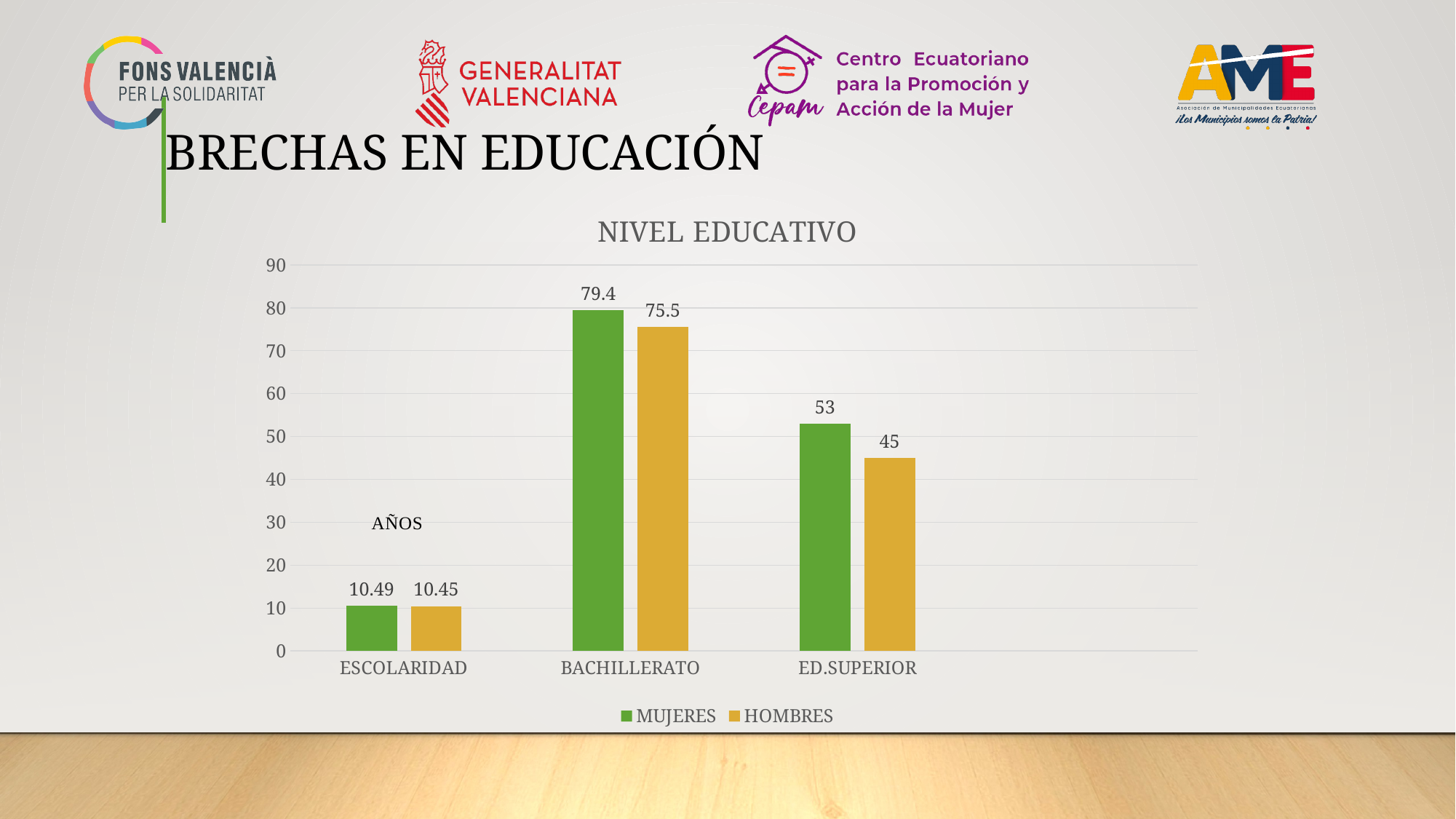
How many series does the legend list? 2 What is the difference between the MUJERES and HOMBRES values in the BACHILLERATO category? 3.9 What type of chart is shown on the slide? Bar chart In the ED.SUPERIOR category, which is larger: MUJERES or HOMBRES? MUJERES What is the value for HOMBRES in the ED.SUPERIOR category? 45 Which category has the lowest value for HOMBRES? ESCOLARIDAD How many categories are shown on the x axis? 3 What is the value for MUJERES in the ESCOLARIDAD category? 10.49 Which category has the highest value for MUJERES? BACHILLERATO What is the difference between the MUJERES and HOMBRES values in the ED.SUPERIOR category? 8 What is the value for HOMBRES in the BACHILLERATO category? 75.5 What is the value for MUJERES in the BACHILLERATO category? 79.4